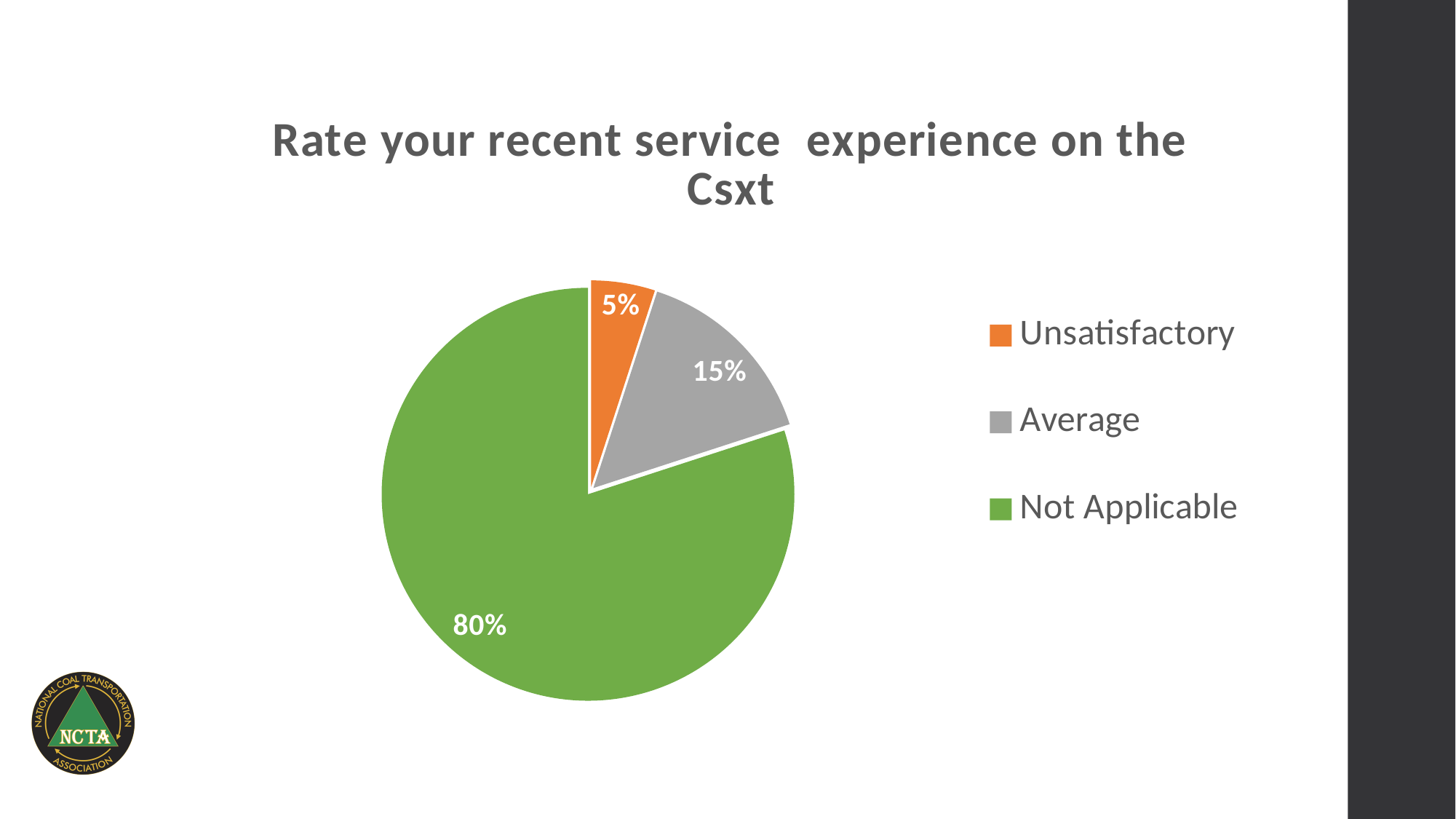
Which slice is larger, Average or Unsatisfactory? Average What share of the pie is labelled Not Applicable? 80% Which colour represents the Average category in the legend? Grey Which category has the smallest slice of the pie? Unsatisfactory How many categories does the pie chart show? 3 What share of the pie is labelled Average? 15% Which category has the largest slice of the pie? Not Applicable What is the title of the chart? Rate your recent service experience on the Csxt What is the difference in percentage points between the Not Applicable and Average slices? 65 What share of the pie is labelled Unsatisfactory? 5% What is the difference in percentage points between the Average and Unsatisfactory slices? 10 What kind of chart is shown on the slide? Pie chart